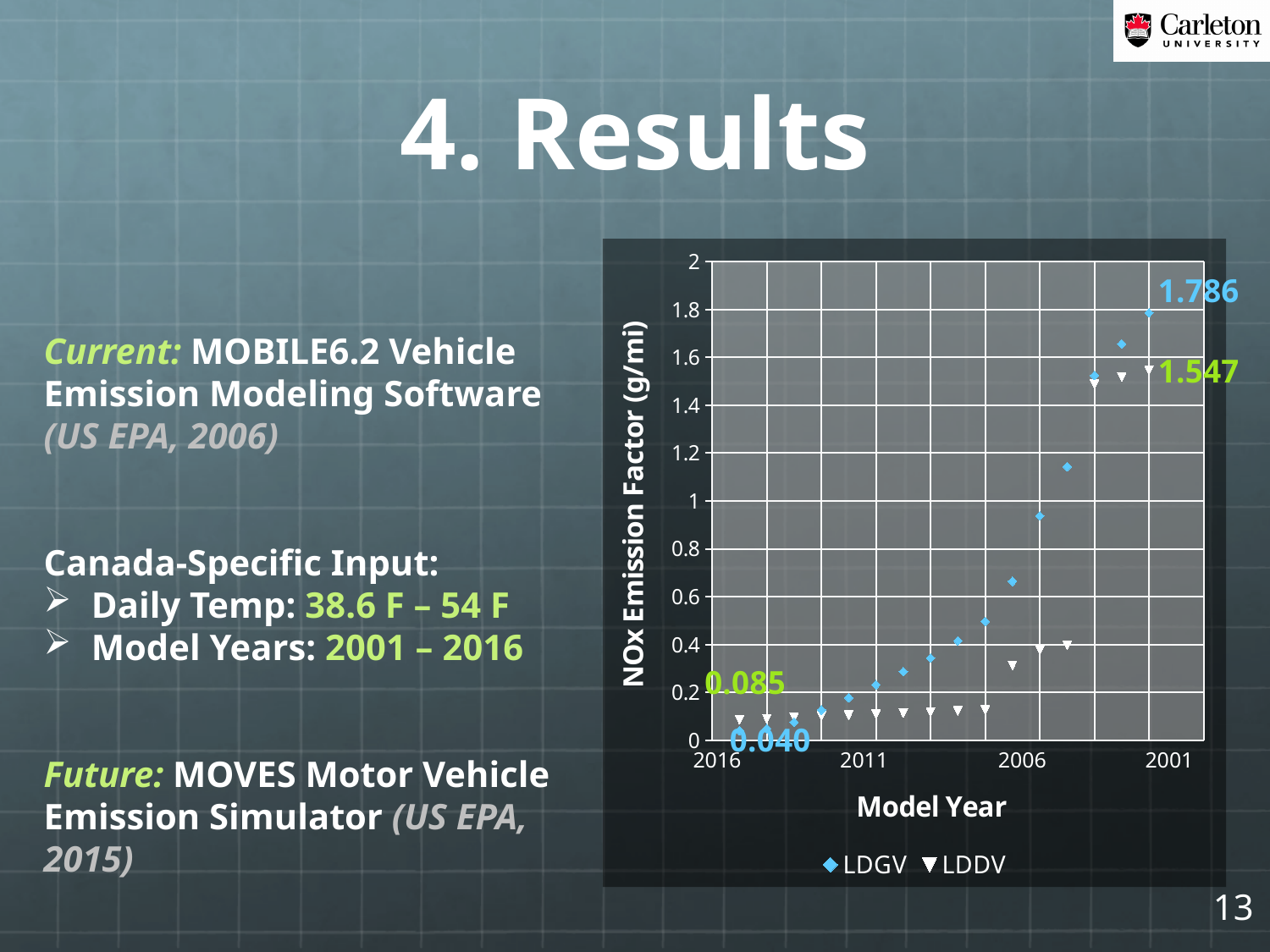
Which series has the larger value at model year 2001, LDGV or LDDV? LDGV What is the NOx emission factor for LDGV at model year 2016? 0.040 Is the LDDV value at model year 2006 greater or less than 0.4? less What is the difference between the LDGV and LDDV values at model year 2001? 0.239 Do the LDGV values rise or fall moving along the x axis from 2016 to 2001? rise What kind of chart is shown on the slide? scatter chart What is the NOx emission factor for LDDV at model year 2016? 0.085 What is the NOx emission factor for LDGV at model year 2001? 1.786 What is the NOx emission factor for LDDV at model year 2001? 1.547 What is the title of the y axis? NOx Emission Factor (g/mi) How many series does the chart legend list? 2 Which series has the larger value at model year 2016, LDGV or LDDV? LDDV